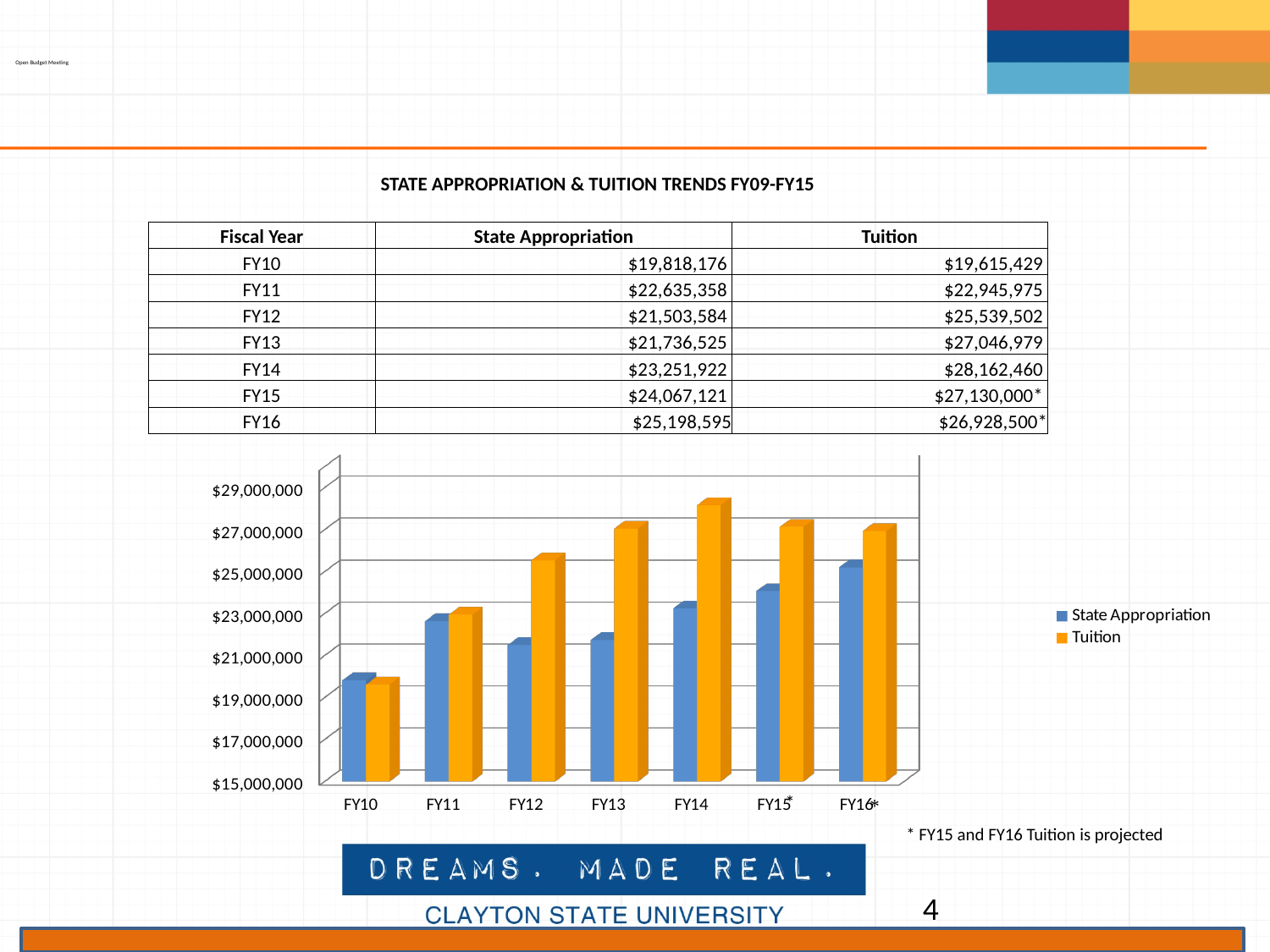
Which fiscal year has the lowest State Appropriation value? FY10 What is the Tuition value for FY12? $25,539,502 What is the State Appropriation value for FY14? $23,251,922 How many fiscal years are plotted on the x axis of the chart? 7 Is the Tuition value for FY14 greater or less than $27,000,000? greater For FY13, which is larger: State Appropriation or Tuition? Tuition Which fiscal year has the highest Tuition value? FY14 Do the State Appropriation values rise or fall from FY13 to FY16? Rise What kind of chart is shown on the slide? Bar chart What is the difference between Tuition and State Appropriation in FY16? $1,729,905 What colour represents Tuition in the chart? Orange How many series does the chart legend list? 2